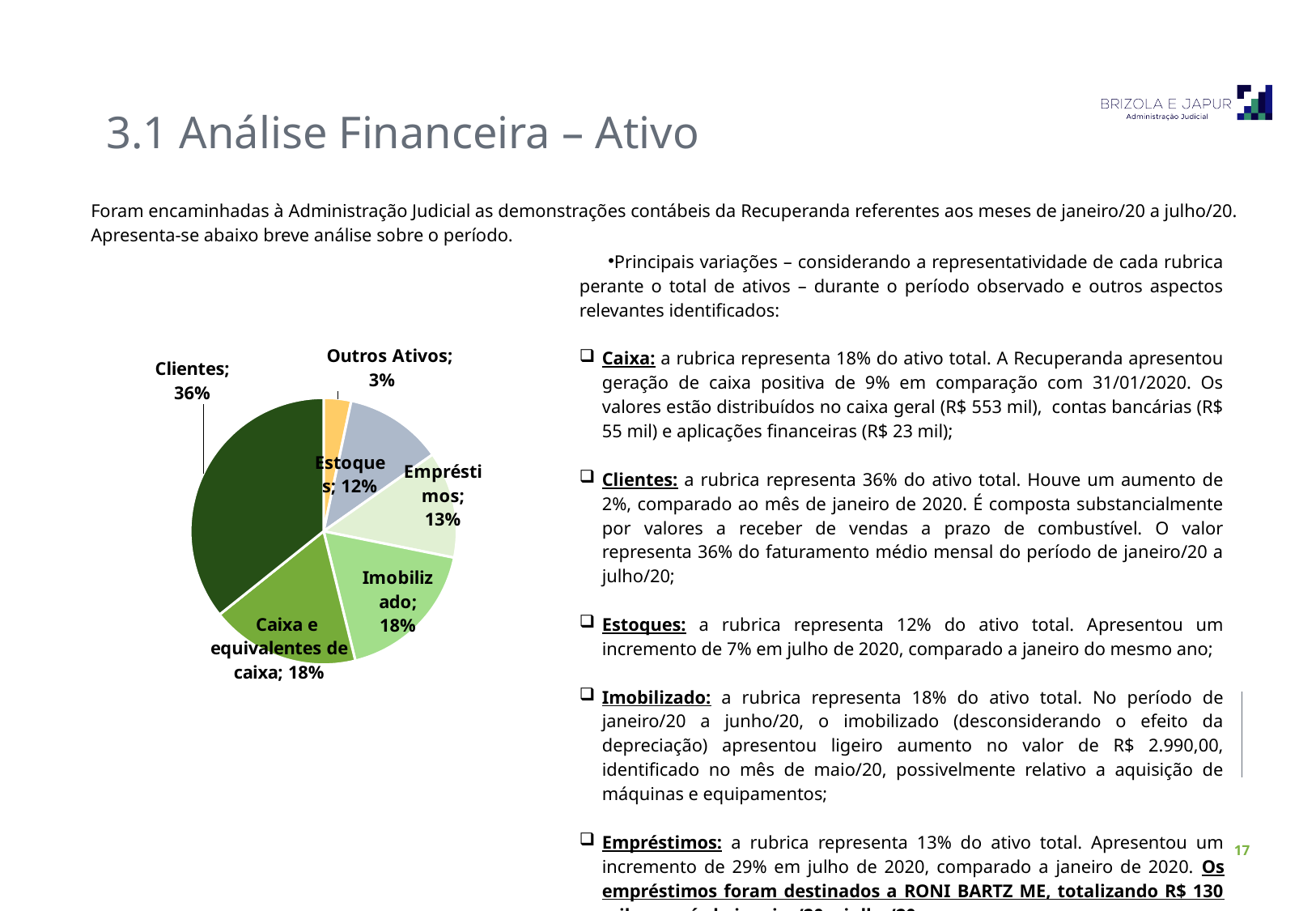
What percentage is shown for Imobilizado? 18% What is the combined share of Caixa e equivalentes de caixa and Imobilizado? 36% What is the value shown for Empréstimos? 13% Which is larger, Empréstimos or Estoques? Empréstimos Which category has the largest slice of the pie? Clientes What is the difference in percentage points between Clientes and Imobilizado? 18 What share of the pie does Clientes represent? 36% How many slices does the pie chart have? 6 What percentage is shown for Estoques? 12% Which category has the smallest slice of the pie? Outros Ativos What is the value shown for Outros Ativos? 3% What kind of chart is shown on the slide? Pie chart